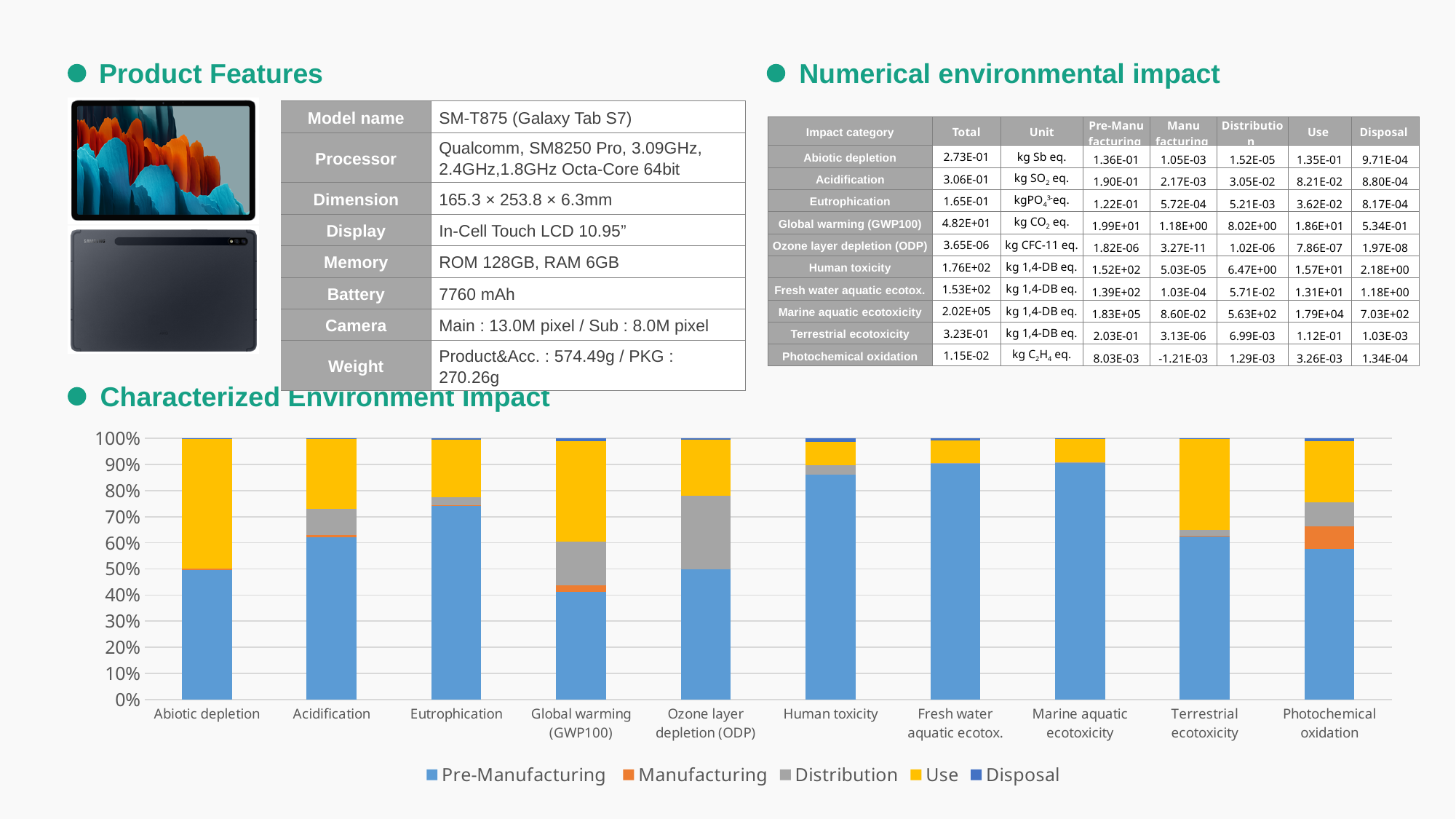
What kind of chart is shown under "Characterized Environment Impact"? Stacked bar chart How many impact categories are plotted along the x axis of the chart? 10 Is the Pre-Manufacturing share for Global warming (GWP100) greater or less than 50%? less Which has a larger Manufacturing share: Photochemical oxidation or Abiotic depletion? Photochemical oxidation Which colour represents the Use series in the chart legend? Yellow Which has a larger Pre-Manufacturing share: Acidification or Human toxicity? Human toxicity Which impact category has the largest Distribution share in the chart? Ozone layer depletion (ODP) Is the Pre-Manufacturing share for Human toxicity greater or less than 80%? greater Is the Pre-Manufacturing share for Eutrophication greater or less than 70%? greater How many series does the chart legend list? 5 Which impact category has the smallest Pre-Manufacturing share in the chart? Global warming (GWP100) Which impact category has the largest Use share in the chart? Abiotic depletion